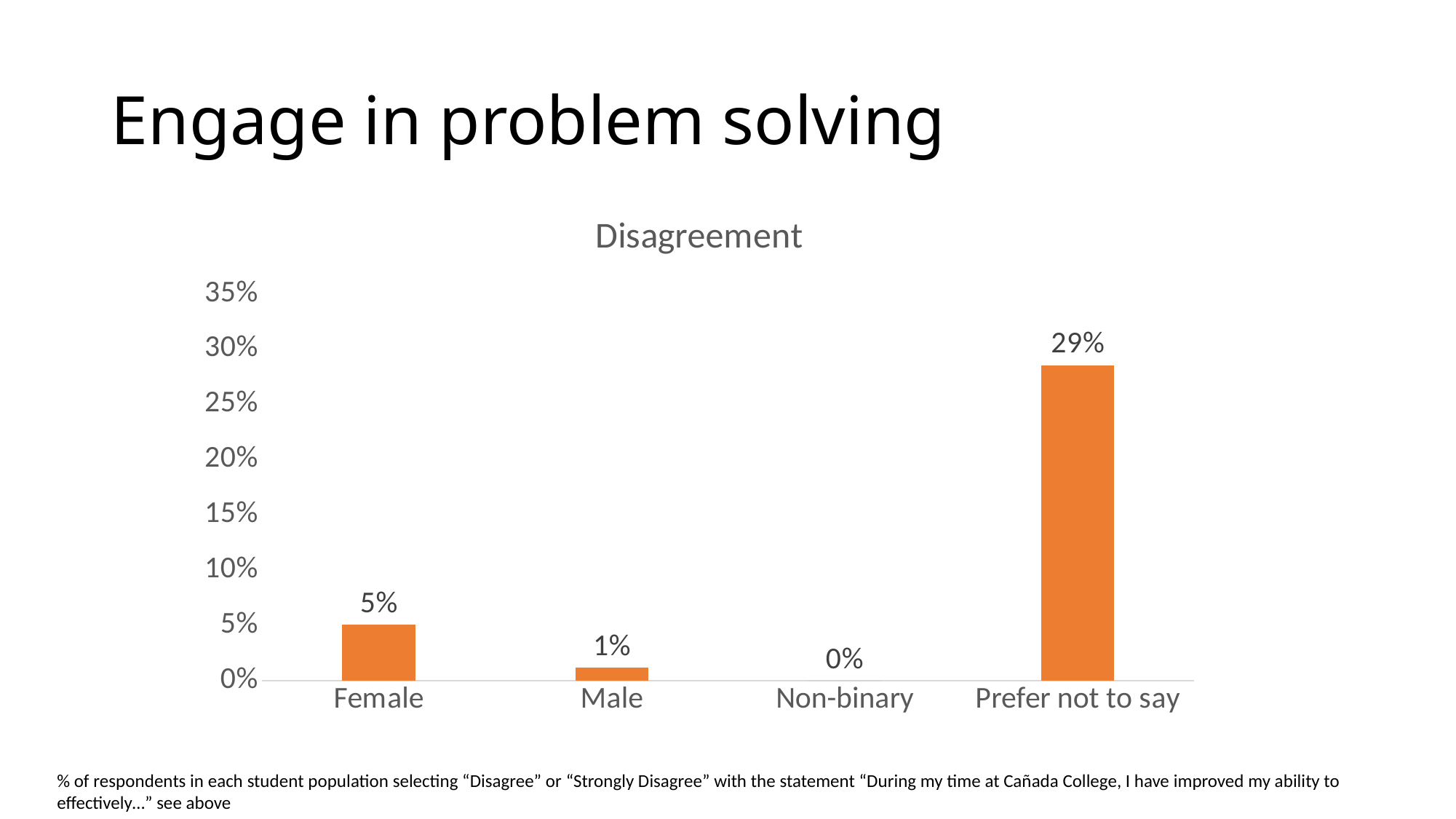
Which category has the lowest disagreement value? Non-binary What type of chart is shown on the slide? Bar chart Which category has the highest disagreement value? Prefer not to say What is the difference between the disagreement values for Female and Male? 4% Which is larger, the disagreement value for Female or for Male? Female What is the difference between the disagreement values for Prefer not to say and Female? 24% What is the disagreement value for Female? 5% What is the disagreement value for Prefer not to say? 29% How many categories are shown on the x axis? 4 Is the value for Prefer not to say greater or less than 25%? greater What is the disagreement value for Male? 1% What is the disagreement value for Non-binary? 0%